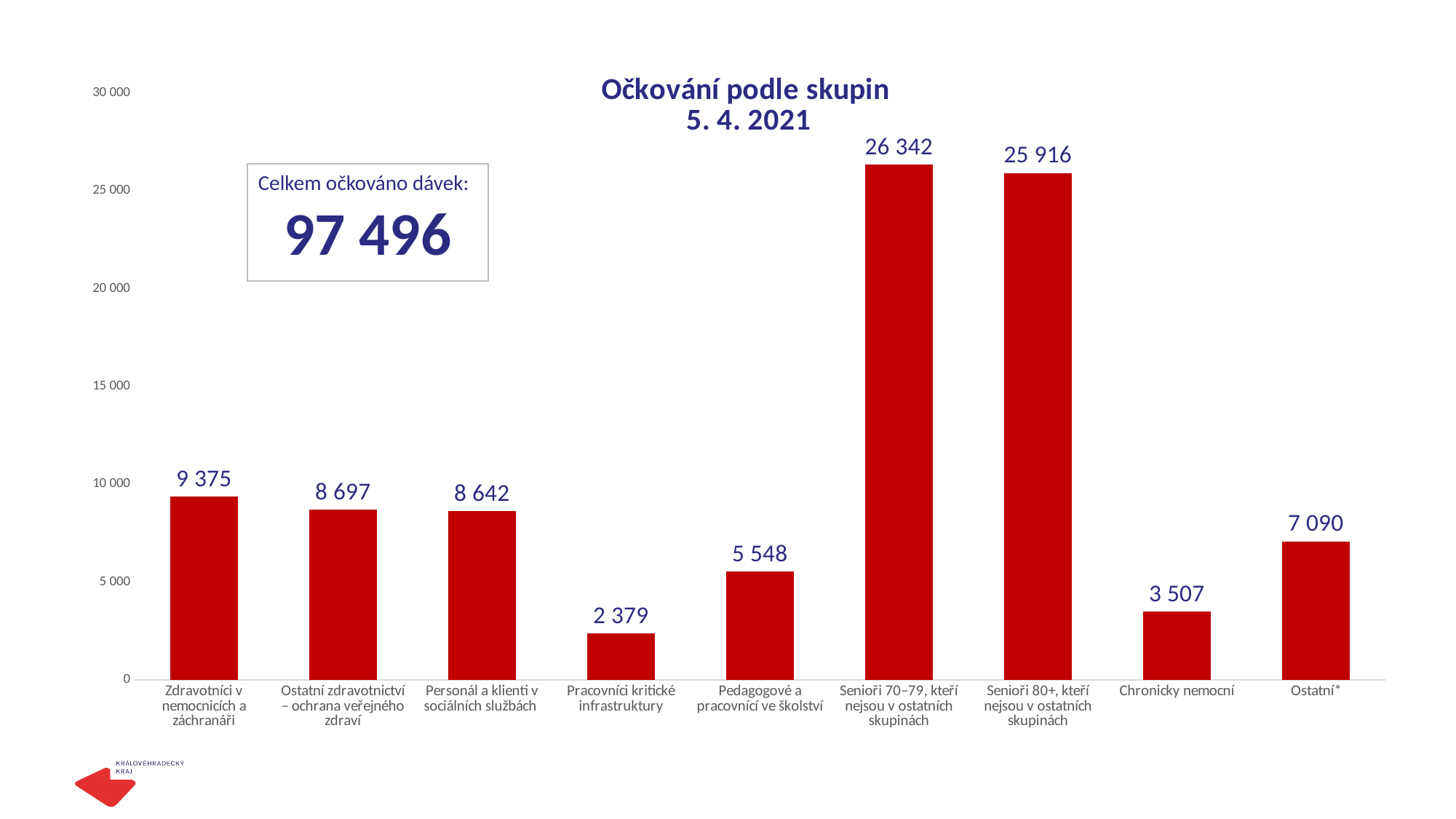
How much larger is the value for Ostatní* than for Chronicky nemocní? 3 583 What type of chart is shown on the slide? bar chart Which is larger: the value for Ostatní* or for Pedagogové a pracovníci ve školství? Ostatní* How many groups (bars) are shown in the chart? 9 What value is shown for Pedagogové a pracovníci ve školství? 5 548 What total number of administered doses is shown in the box on the slide? 97 496 Which group has the lowest value? Pracovníci kritické infrastruktury What is the difference between the values for Senioři 70–79 and Senioři 80+? 426 Is the value for Chronicky nemocní greater or less than 5 000? less What is the value for Zdravotníci v nemocnicích a záchranáři? 9 375 Which group has the highest bar? Senioři 70–79, kteří nejsou v ostatních skupinách How many doses are shown for Chronicky nemocní? 3 507